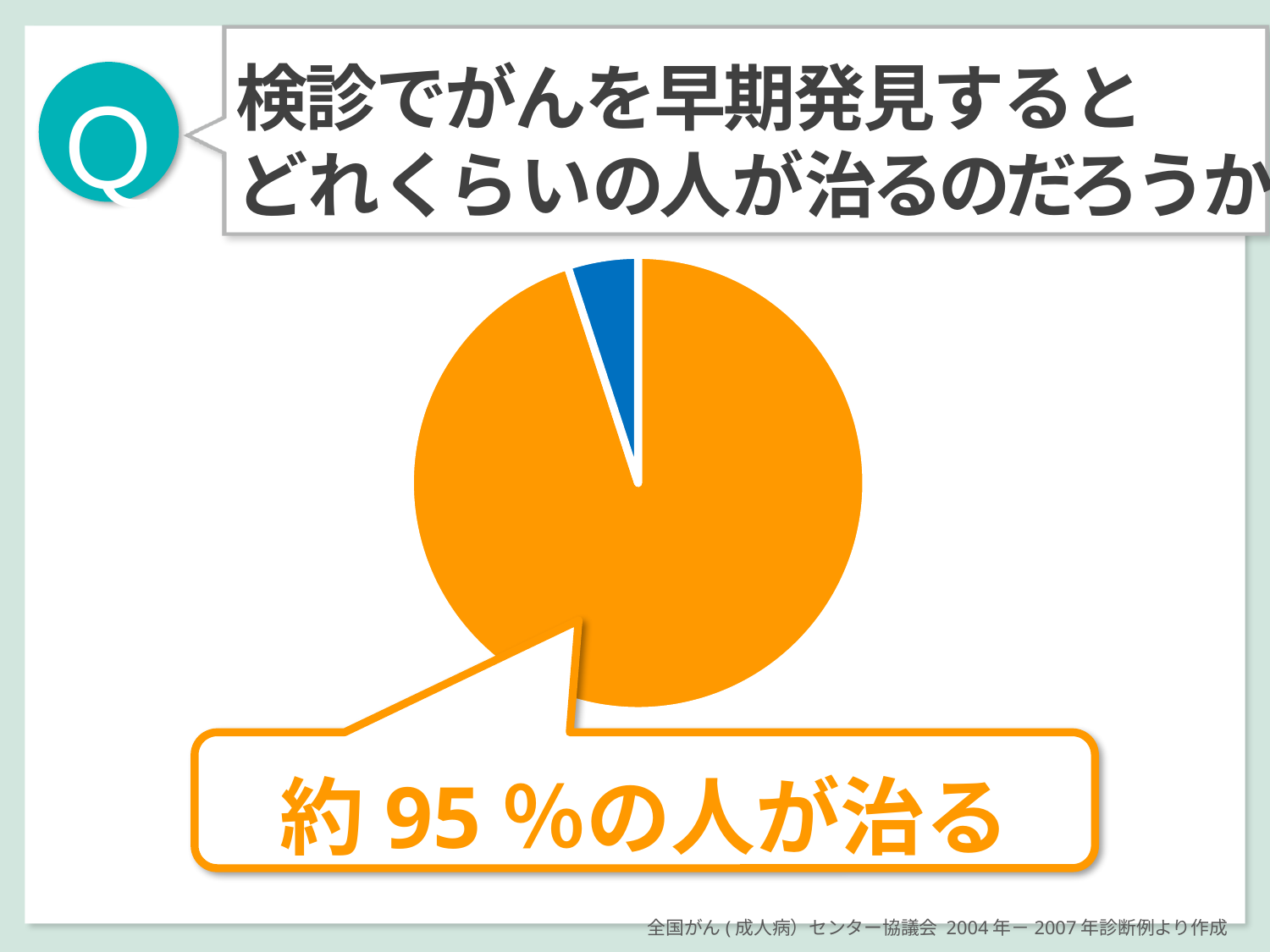
Which slice is larger, the orange slice or the blue slice? orange According to the callout label, what share of people are cured (the orange slice)? 約95% Which colour slice is the smallest in the pie chart? blue Is the orange slice greater or less than 50% of the pie? greater What kind of chart is shown on the slide? pie chart What question is posed in the title box at the top of the slide? 検診でがんを早期発見するとどれくらいの人が治るのだろうか Which colour slice is the largest in the pie chart? orange How many slices does the pie chart have? 2 What does the callout attached to the orange slice say? 約95%の人が治る